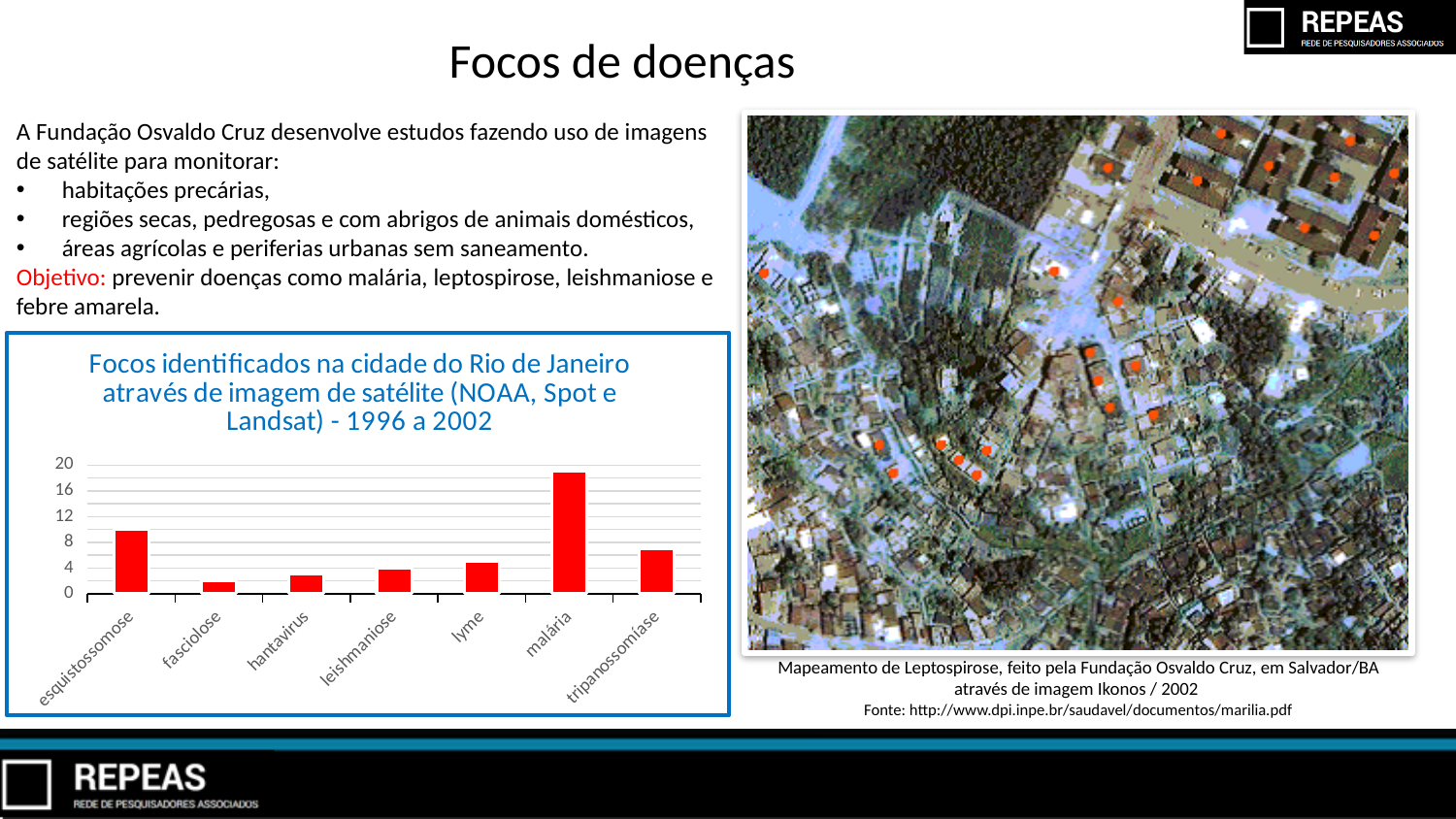
Which is larger, the value for malária or the value for esquistossomose? malária Is the value for malária greater or less than 16? greater What kind of chart is shown on the slide? bar chart Is the value for tripanossomíase greater or less than 4? greater Is the value for fasciolose greater or less than 4? less Which category has the lowest value in the chart? fasciolose Which category has the highest value in the chart? malária What is the title of the chart? Focos identificados na cidade do Rio de Janeiro através de imagem de satélite (NOAA, Spot e Landsat) - 1996 a 2002 How many categories are labeled on the x axis of the chart? 7 Which is larger, the value for esquistossomose or the value for tripanossomíase? esquistossomose